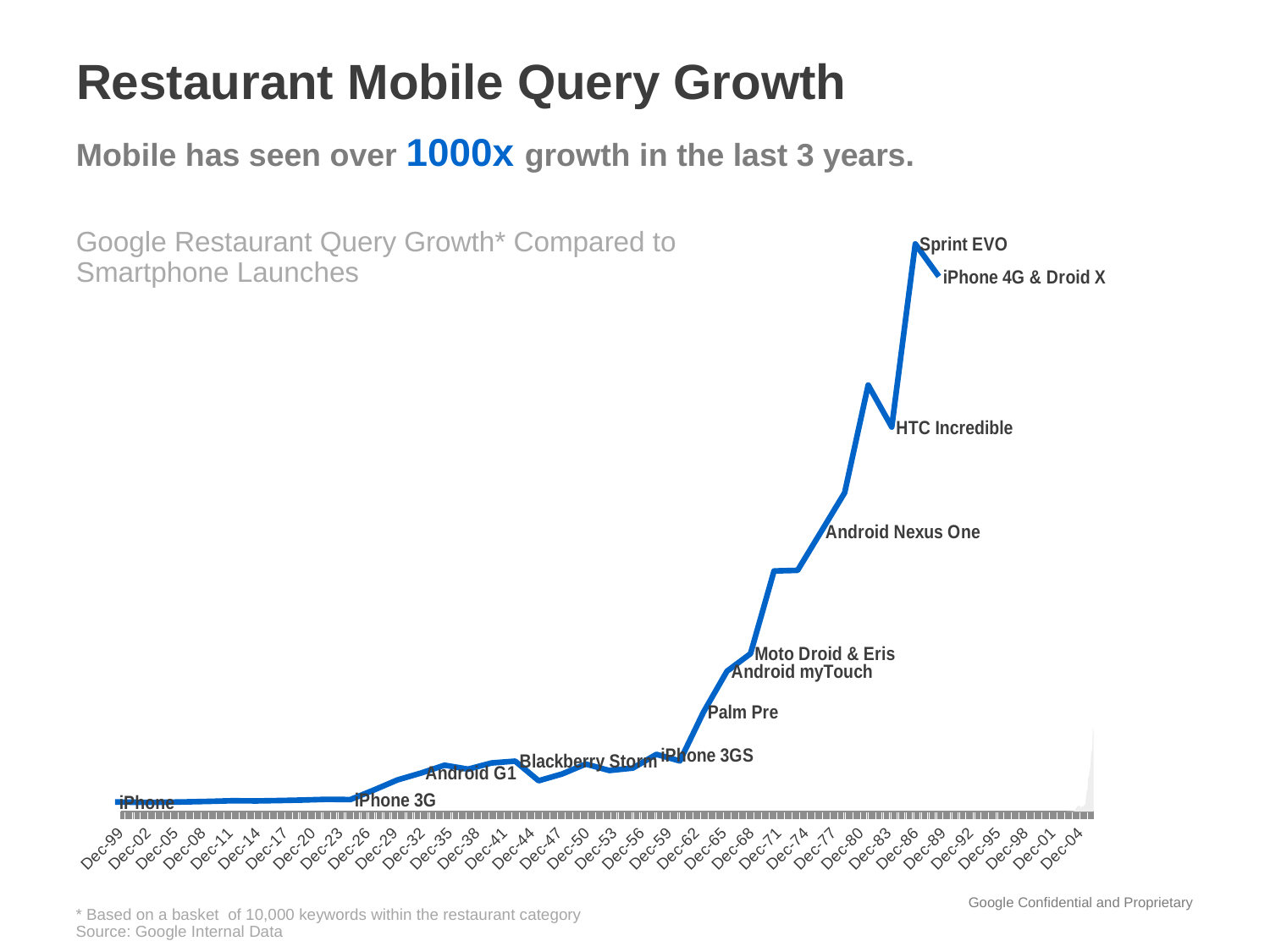
Is the line higher at the Moto Droid & Eris annotation or at the Android G1 annotation? Moto Droid & Eris Is the line higher at the HTC Incredible annotation or at the Android Nexus One annotation? HTC Incredible Which smartphone launch is annotated at the lowest point of the line? iPhone Is the line higher at the Palm Pre annotation or at the iPhone 3GS annotation? Palm Pre Which smartphone launch annotation appears first (leftmost) on the line? iPhone What is the title of the chart? Google Restaurant Query Growth* Compared to Smartphone Launches What kind of chart is shown on the slide? line chart How many smartphone launch annotations are placed on the line? 12 Which smartphone launch is annotated at the highest point of the line? Sprint EVO Do the restaurant query values generally rise or fall along the x axis? rise